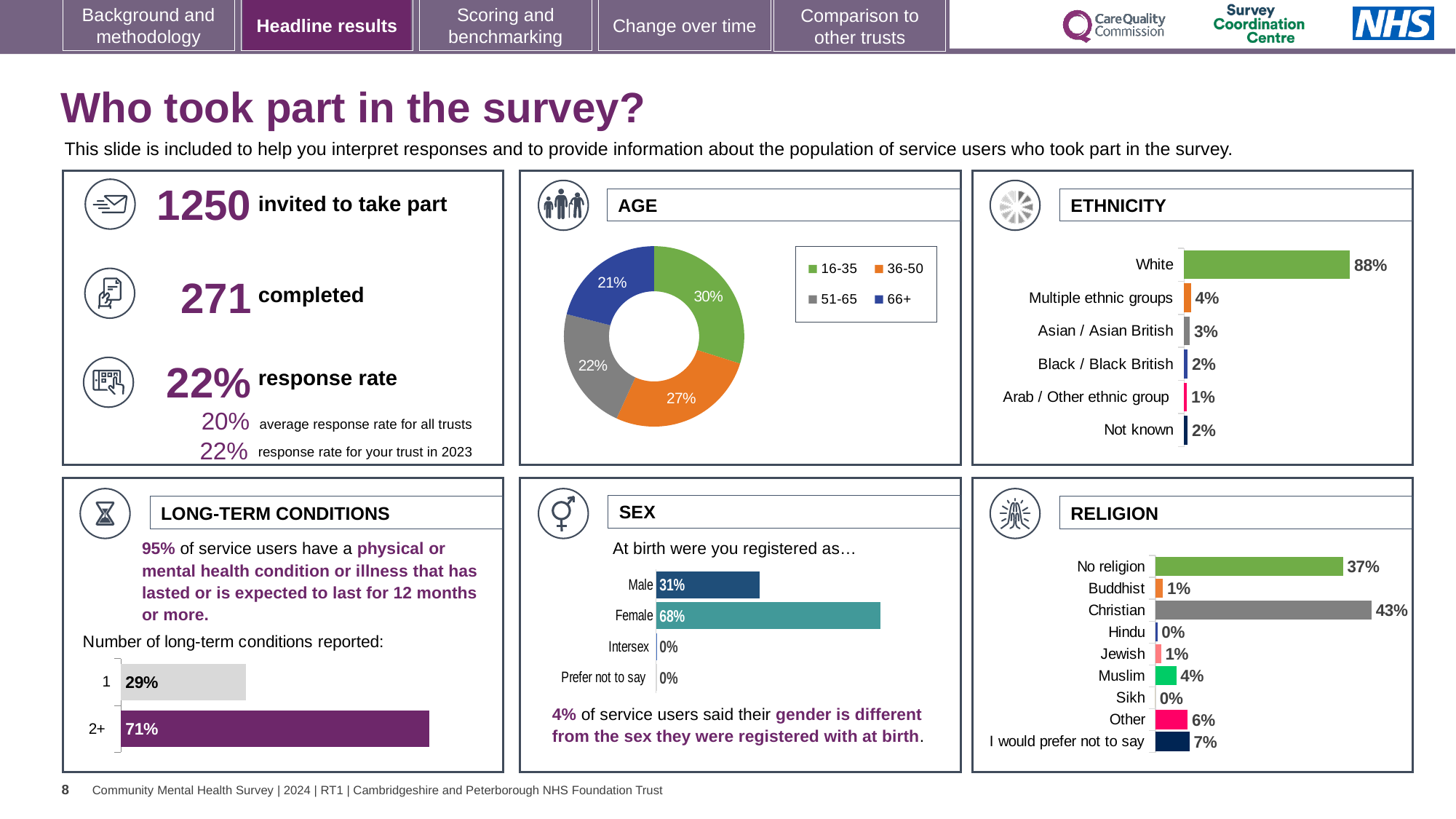
How many age groups does the legend of the AGE chart list? 4 In the AGE chart, which age group has the smallest share? 66+ In the ETHNICITY chart, what is the value for White? 88% In the ETHNICITY chart, what is the difference between White and Multiple ethnic groups? 84% In the AGE chart, what percentage of respondents were aged 16-35? 30% What kind of chart is the AGE chart? Doughnut chart How many categories are shown in the ETHNICITY chart? 6 In the LONG-TERM CONDITIONS chart, what percentage reported 2+ long-term conditions? 71% In the RELIGION chart, what is the difference between Christian and No religion? 6% In the RELIGION chart, which category has the highest value? Christian In the SEX chart, which is larger, Male or Female? Female In the SEX chart, what is the value for Female? 68%